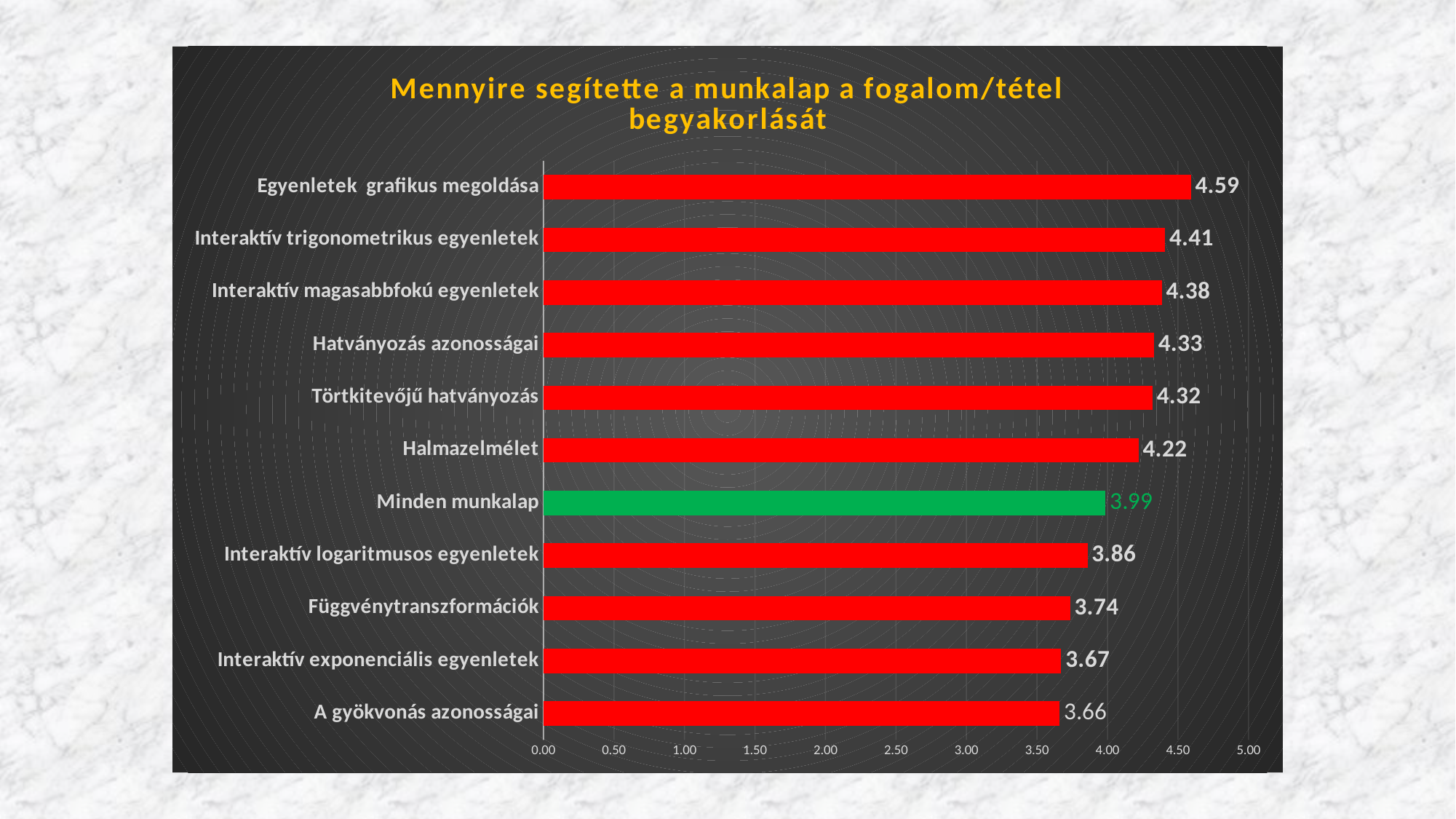
Which is larger, the value for Interaktív trigonometrikus egyenletek or the value for Interaktív logaritmusos egyenletek? Interaktív trigonometrikus egyenletek Is the value for Interaktív exponenciális egyenletek greater or less than 4.00? less What kind of chart is shown on the slide? bar chart Which category has the highest value? Egyenletek grafikus megoldása What is the value for Függvénytranszformációk? 3.74 What is the difference between the values for Halmazelmélet and Minden munkalap? 0.23 Which category's bar is coloured green instead of red? Minden munkalap What is the value for Egyenletek grafikus megoldása? 4.59 Which category has the lowest value? A gyökvonás azonosságai What is the value for Minden munkalap? 3.99 How many categories are shown in the chart? 11 What is the difference between the values for Egyenletek grafikus megoldása and A gyökvonás azonosságai? 0.93